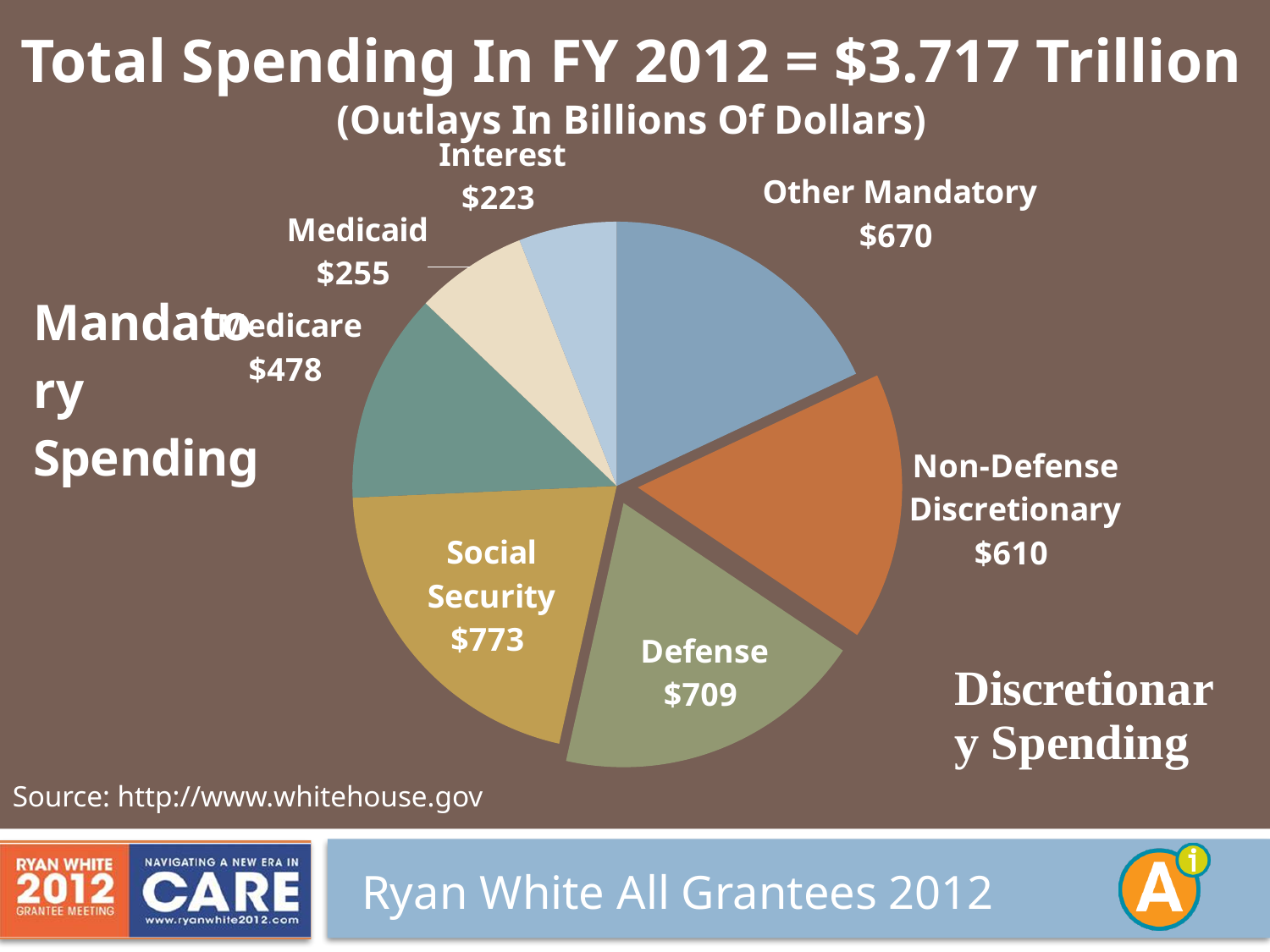
What is the difference between Social Security and Defense? $64 Which is larger, Other Mandatory or Non-Defense Discretionary? Other Mandatory What is the value for Defense? $709 What kind of chart is shown on the slide? Pie chart How many slices does the pie chart have? 7 What is the value for Interest? $223 What is the value for Social Security? $773 Which category has the largest slice of the pie? Social Security Which category has the smallest slice of the pie? Interest What is the value for Non-Defense Discretionary? $610 What total spending figure is given in the chart title? $3.717 Trillion What is the difference between Medicare and Medicaid? $223